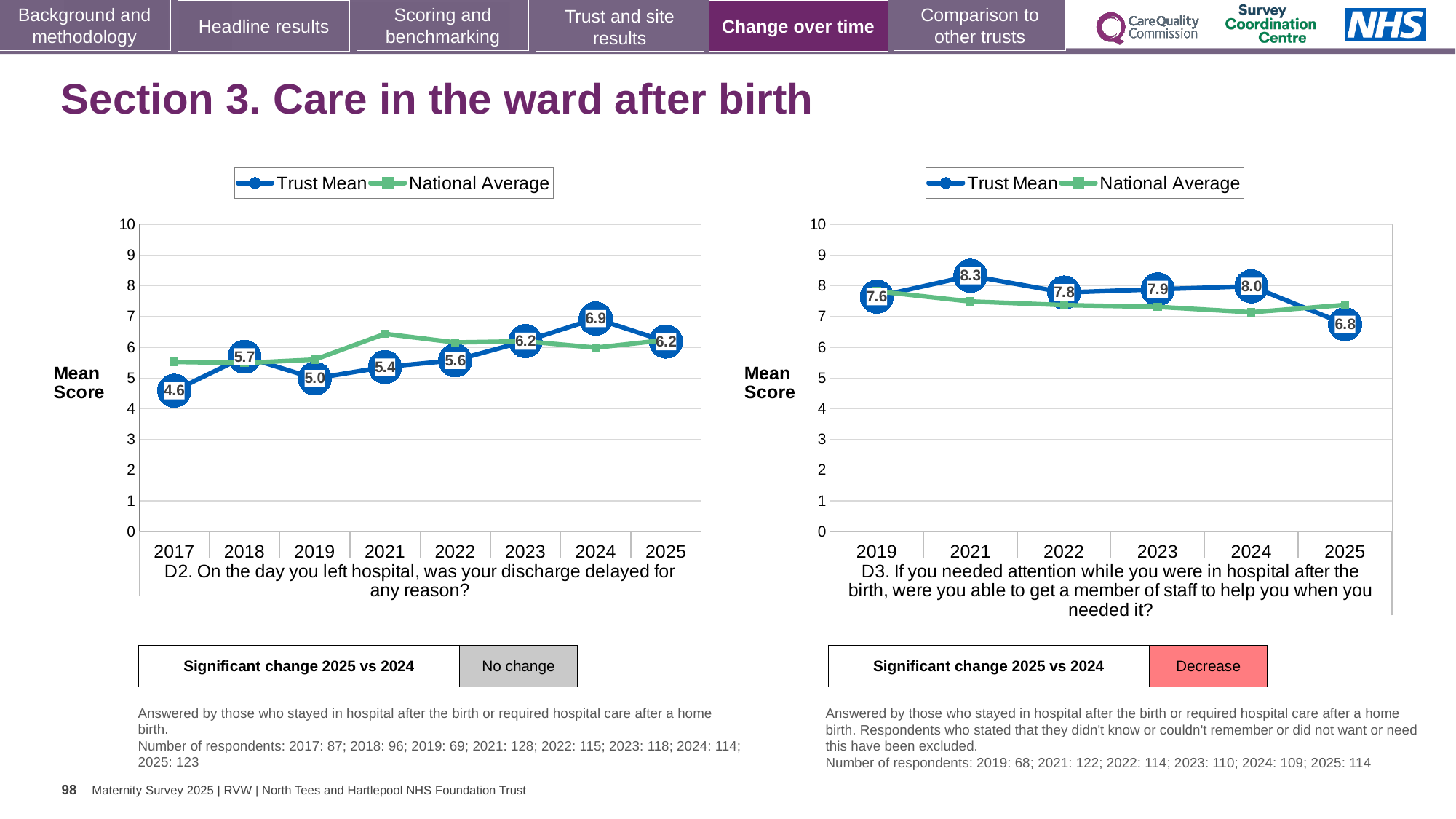
In the left chart (D2), what is the difference between the Trust Mean scores for 2024 and 2025? 0.7 In the left chart (D2), which year has the highest Trust Mean score? 2024 How many series does the legend of the right chart (D3) list? 2 In the left chart (D2), which year has the lowest Trust Mean score? 2017 In the right chart (D3), is the National Average value for 2025 greater or less than 7? greater What kind of chart is the left chart (D2)? Line chart In the left chart (D2), what is the Trust Mean score for 2017? 4.6 In the left chart (D2), how many years are shown on the x axis? 8 In the right chart (D3), what is the Trust Mean score for 2021? 8.3 In the right chart (D3), is the Trust Mean score for 2019 or 2025 larger? 2019 In the left chart (D2), what is the Trust Mean score for 2024? 6.9 In the right chart (D3), which year has the lowest Trust Mean score? 2025